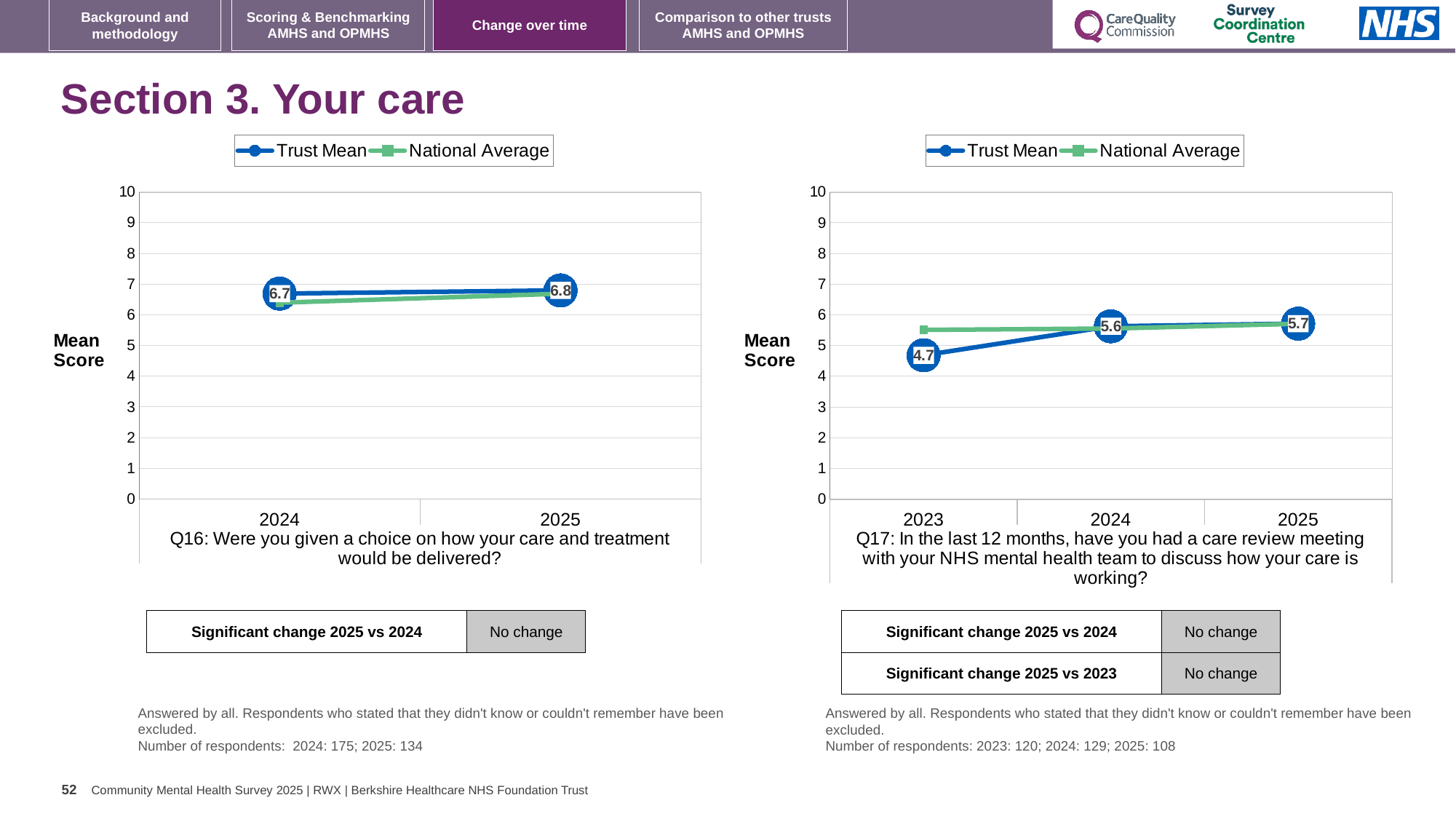
In the Q17 chart on the right, what is the Trust Mean for 2025? 5.7 In the Q16 chart on the left, what is the Trust Mean for 2025? 6.8 In the Q17 chart on the right, is the Trust Mean or the National Average higher in 2023? National Average How many series does the legend of the Q16 chart on the left list? 2 What type of chart is used for Q17 on the right? Line chart In the Q17 chart on the right, by how much did the Trust Mean increase from 2023 to 2025? 1.0 How many years are plotted on the x axis of the Q17 chart on the right? 3 In the Q17 chart on the right, which year has the lowest Trust Mean? 2023 In the Q17 chart on the right, what is the Trust Mean for 2023? 4.7 In the Q16 chart on the left, what is the Trust Mean for 2024? 6.7 In the Q16 chart on the left, what is the difference between the Trust Mean for 2025 and 2024? 0.1 In the Q17 chart on the right, is the National Average for 2023 greater or less than 5? greater